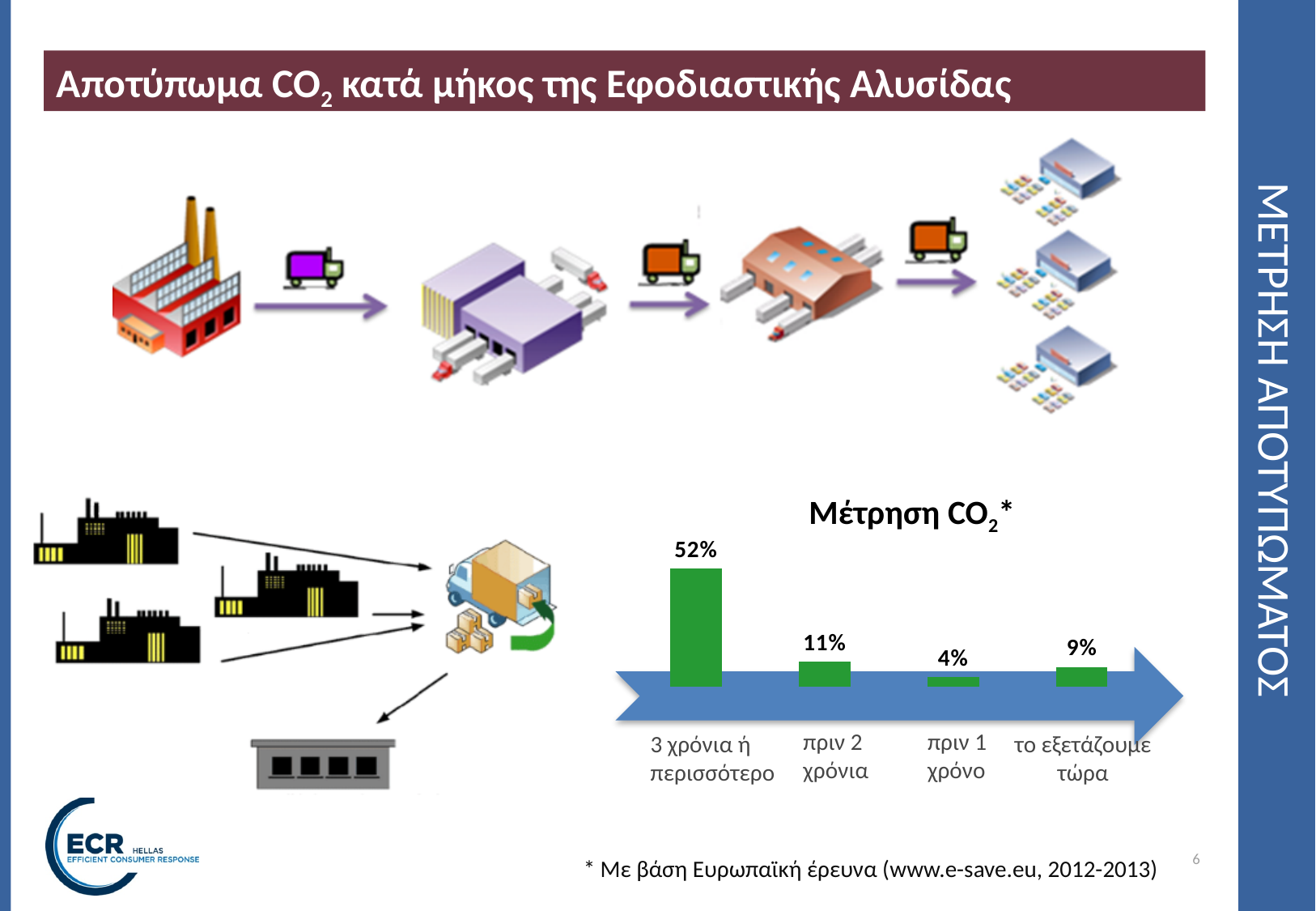
What is the value for 'το εξετάζουμε τώρα' in the Μέτρηση CO2 chart? 9% Which category has the lowest value in the Μέτρηση CO2 chart? πριν 1 χρόνο Which category has the highest value in the Μέτρηση CO2 chart? 3 χρόνια ή περισσότερο What is the difference between the values for 'το εξετάζουμε τώρα' and 'πριν 1 χρόνο' in the Μέτρηση CO2 chart? 5% What is the value for 'πριν 2 χρόνια' in the Μέτρηση CO2 chart? 11% What is the value for '3 χρόνια ή περισσότερο' in the Μέτρηση CO2 chart? 52% What is the difference between the values for '3 χρόνια ή περισσότερο' and 'πριν 2 χρόνια' in the Μέτρηση CO2 chart? 41% What is the value for 'πριν 1 χρόνο' in the Μέτρηση CO2 chart? 4% What kind of chart is the Μέτρηση CO2 chart? Bar chart Which is larger in the Μέτρηση CO2 chart: 'πριν 2 χρόνια' or 'το εξετάζουμε τώρα'? πριν 2 χρόνια How many categories are shown in the Μέτρηση CO2 chart? 4 What is the title of the chart on the slide? Μέτρηση CO2*